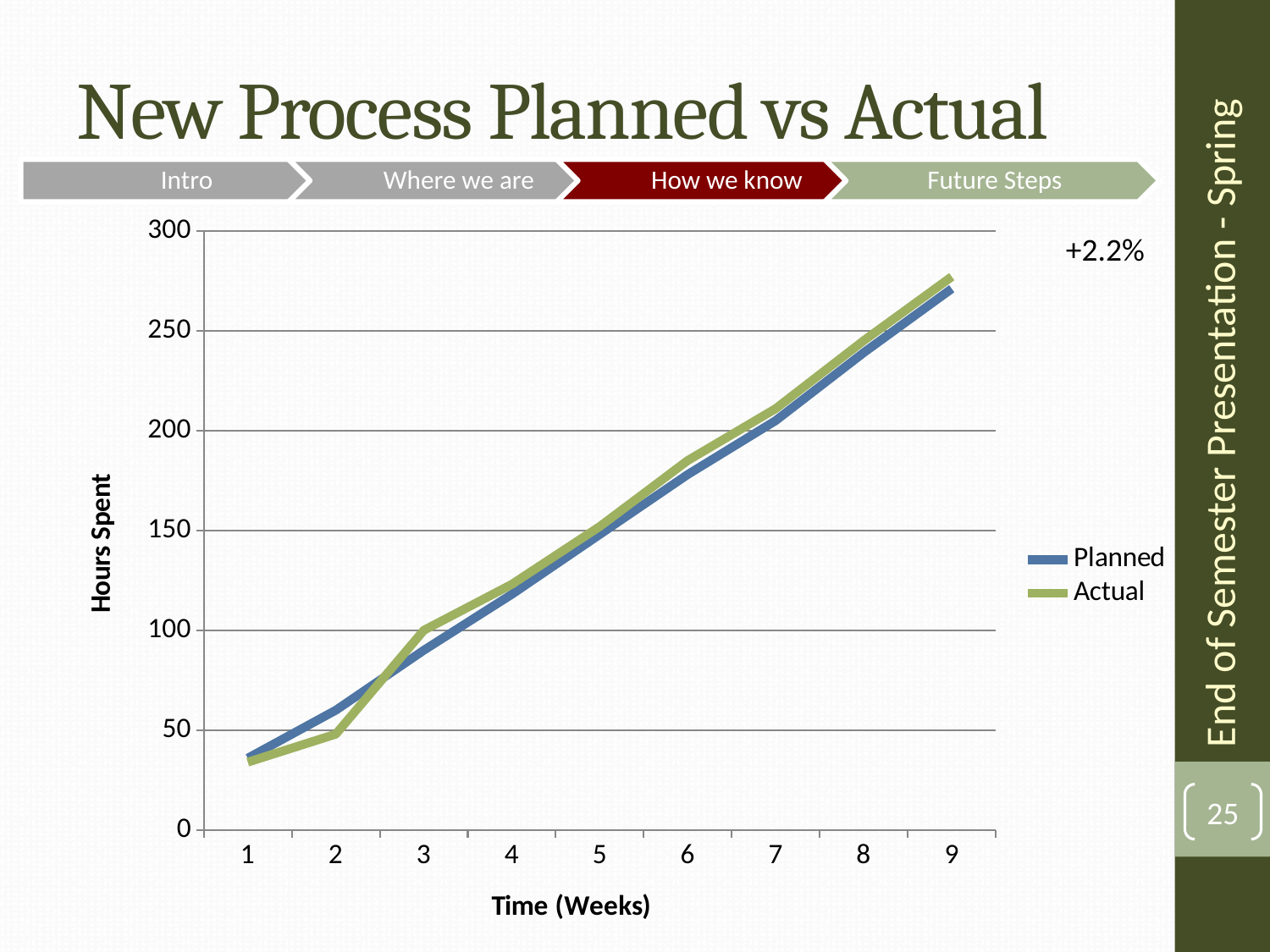
What is the title of the y axis? Hours Spent Is the Actual value at week 6 greater or less than 150? greater At week 2, which series has the higher value, Planned or Actual? Planned Do the Actual hours rise or fall from week 1 to week 9? rise What kind of chart is shown on the slide? line chart Is the Planned value at week 1 greater or less than 50? less Is the Actual value at week 9 greater or less than 250? greater At week 3, which series has the higher value, Planned or Actual? Actual How many weeks are plotted along the x axis? 9 What percentage annotation is shown at the top right of the chart? +2.2% How many series does the legend list? 2